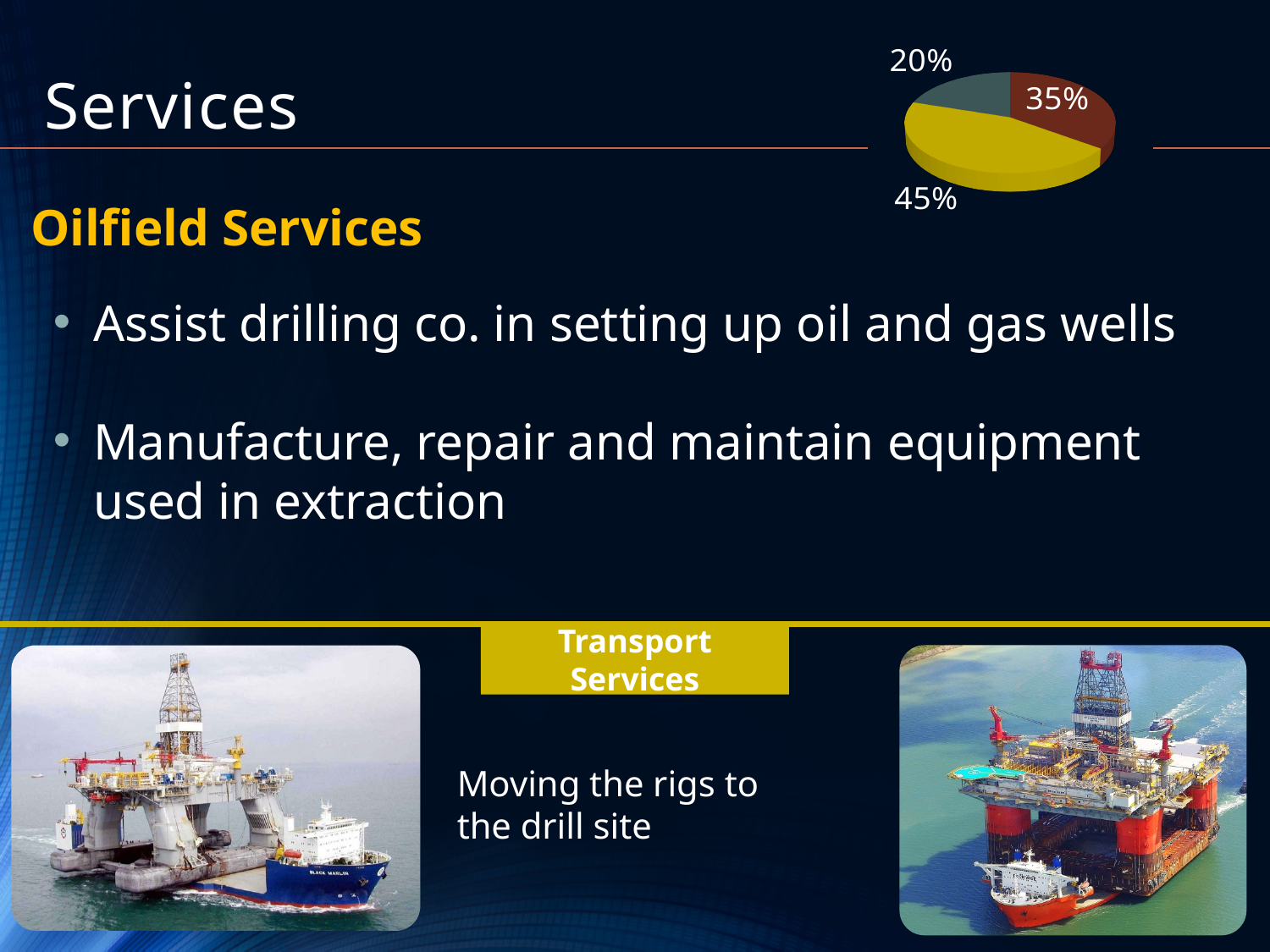
What is the difference between the largest and smallest slices of the pie chart? 25% How many slices does the pie chart have? 3 What is the smallest share shown in the pie chart? 20% Which colour is the largest slice of the pie chart? yellow What is the difference between the 45% slice and the 35% slice in the pie chart? 10% What percentage does the dark teal slice of the pie chart represent? 20% What percentage does the dark red slice of the pie chart represent? 35% What percentage does the yellow slice of the pie chart represent? 45% Does the pie chart have a legend? No What is the largest share shown in the pie chart? 45% Which slice of the pie chart is larger, the yellow one or the dark red one? the yellow one What kind of chart is shown at the top right of the slide? pie chart